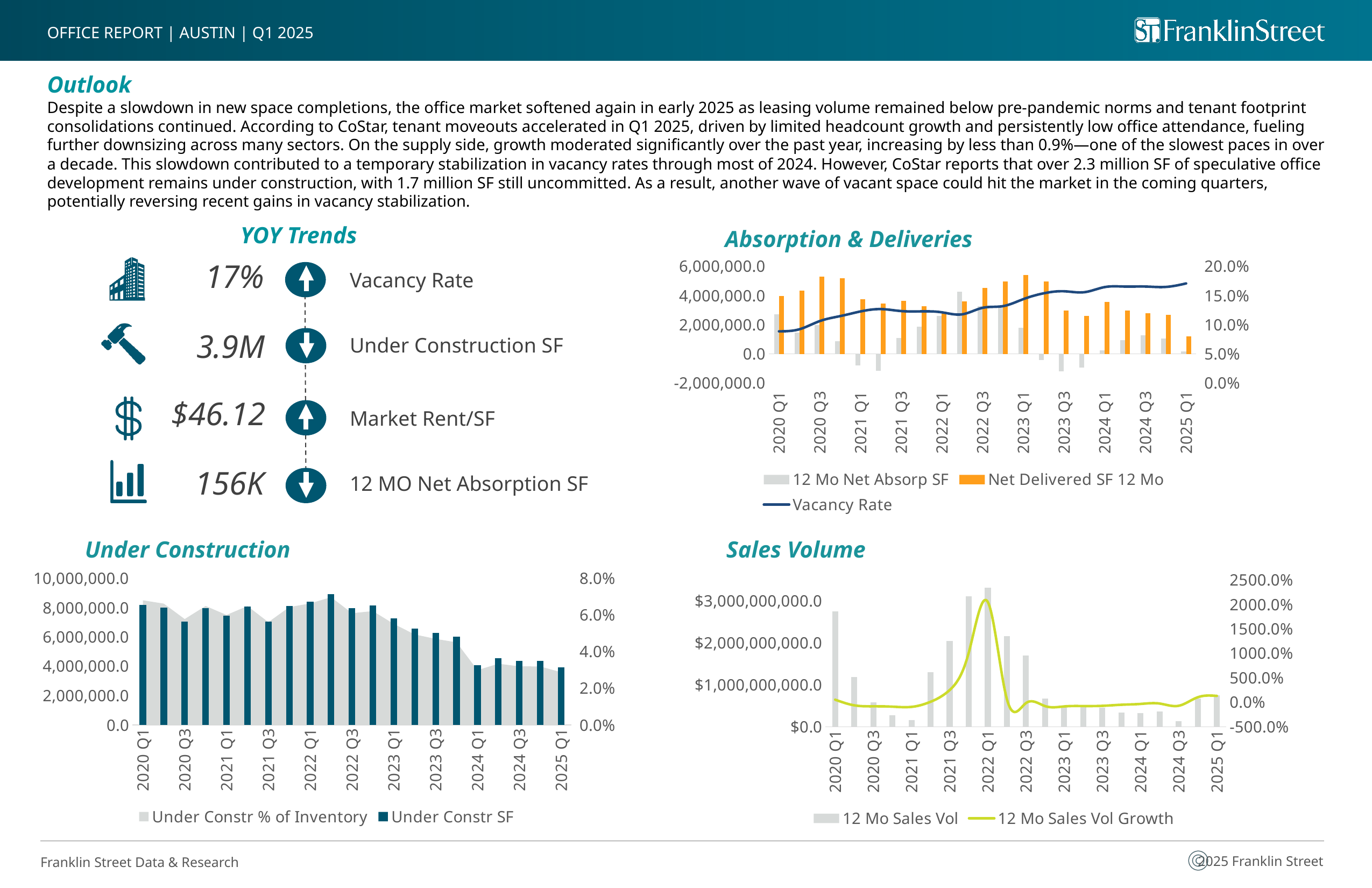
In the Absorption & Deliveries chart, does the Vacancy Rate line rise or fall from 2020 Q1 to 2025 Q1? rises In the Absorption & Deliveries chart, is the Vacancy Rate in 2025 Q1 greater or less than 15.0%? greater How many series does the legend of the Under Construction chart list? 2 How many quarterly bars are plotted in the Under Construction chart? 21 In the Under Construction chart, in which year does the Under Constr SF reach its highest bar? 2022 How many series does the legend of the Sales Volume chart list? 2 In the Sales Volume chart, is the 12 Mo Sales Vol bar for 2022 Q1 greater or less than $3,000,000,000.0? greater In the Absorption & Deliveries chart, is the Net Delivered SF 12 Mo bar for 2020 Q3 greater or less than 4,000,000.0? greater How many series does the legend of the Absorption & Deliveries chart list? 3 In the Sales Volume chart, what colour is the 12 Mo Sales Vol Growth line? yellow-green